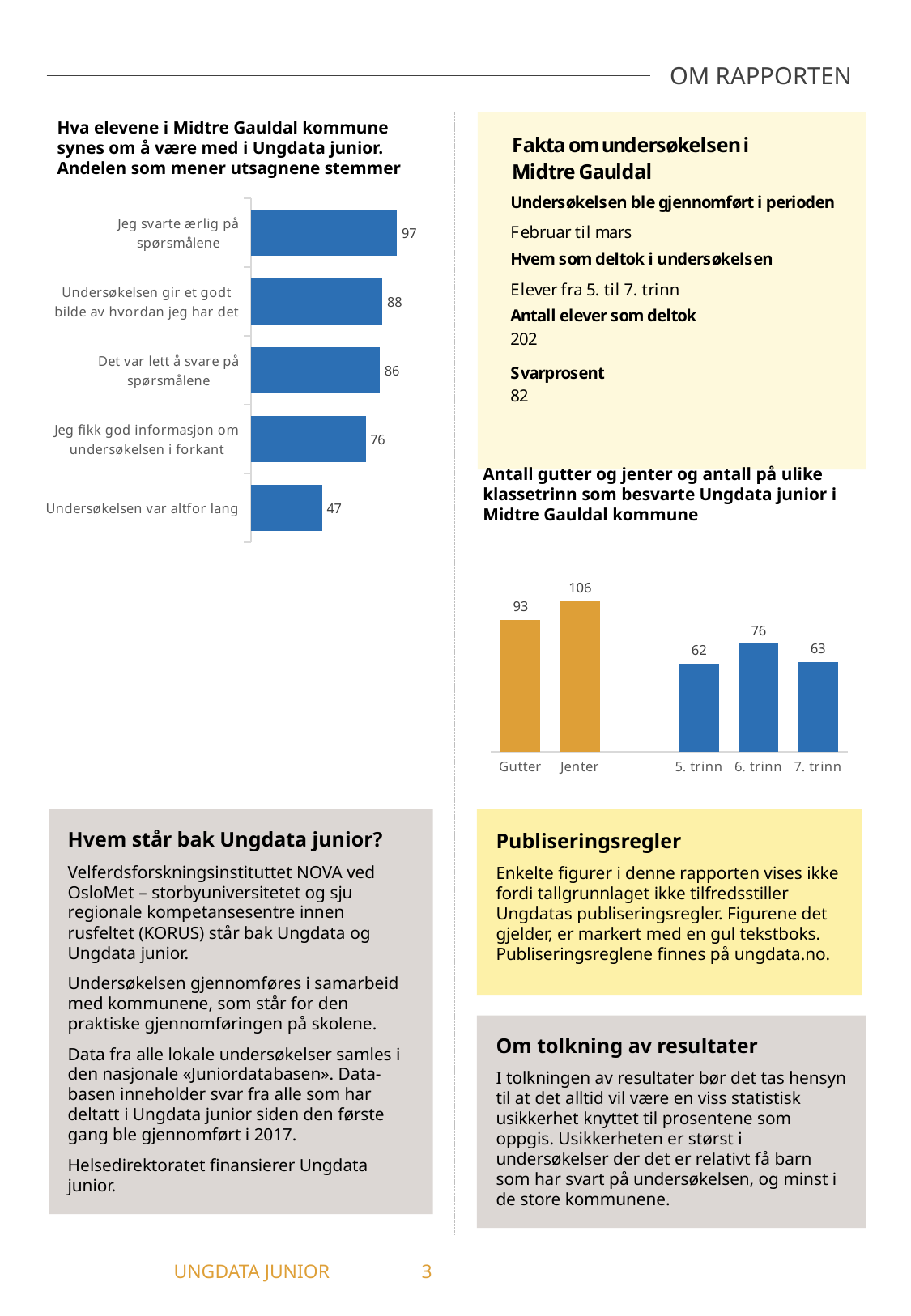
In the right chart showing the number of boys and girls and pupils per grade, which is larger, Gutter or Jenter? Jenter In the left chart about what pupils think of taking part in Ungdata junior, how many statements are shown? 5 What kind of chart is the left chart about what pupils think of taking part in Ungdata junior? Bar chart In the right chart showing the number of boys and girls and pupils per grade, what is the difference between Jenter and Gutter? 13 In the right chart showing the number of boys and girls and pupils per grade, what is the value for Jenter? 106 In the left chart about what pupils think of taking part in Ungdata junior, what is the difference between "Undersøkelsen gir et godt bilde av hvordan jeg har det" and "Jeg fikk god informasjon om undersøkelsen i forkant"? 12 In the left chart about what pupils think of taking part in Ungdata junior, what is the value for "Jeg svarte ærlig på spørsmålene"? 97 In the left chart about what pupils think of taking part in Ungdata junior, what is the value for "Undersøkelsen var altfor lang"? 47 In the right chart showing the number of boys and girls and pupils per grade, which category has the highest value? Jenter In the right chart showing the number of boys and girls and pupils per grade, how many categories are shown? 5 In the left chart about what pupils think of taking part in Ungdata junior, which statement has the lowest value? Undersøkelsen var altfor lang In the right chart showing the number of boys and girls and pupils per grade, what is the value for 6. trinn? 76